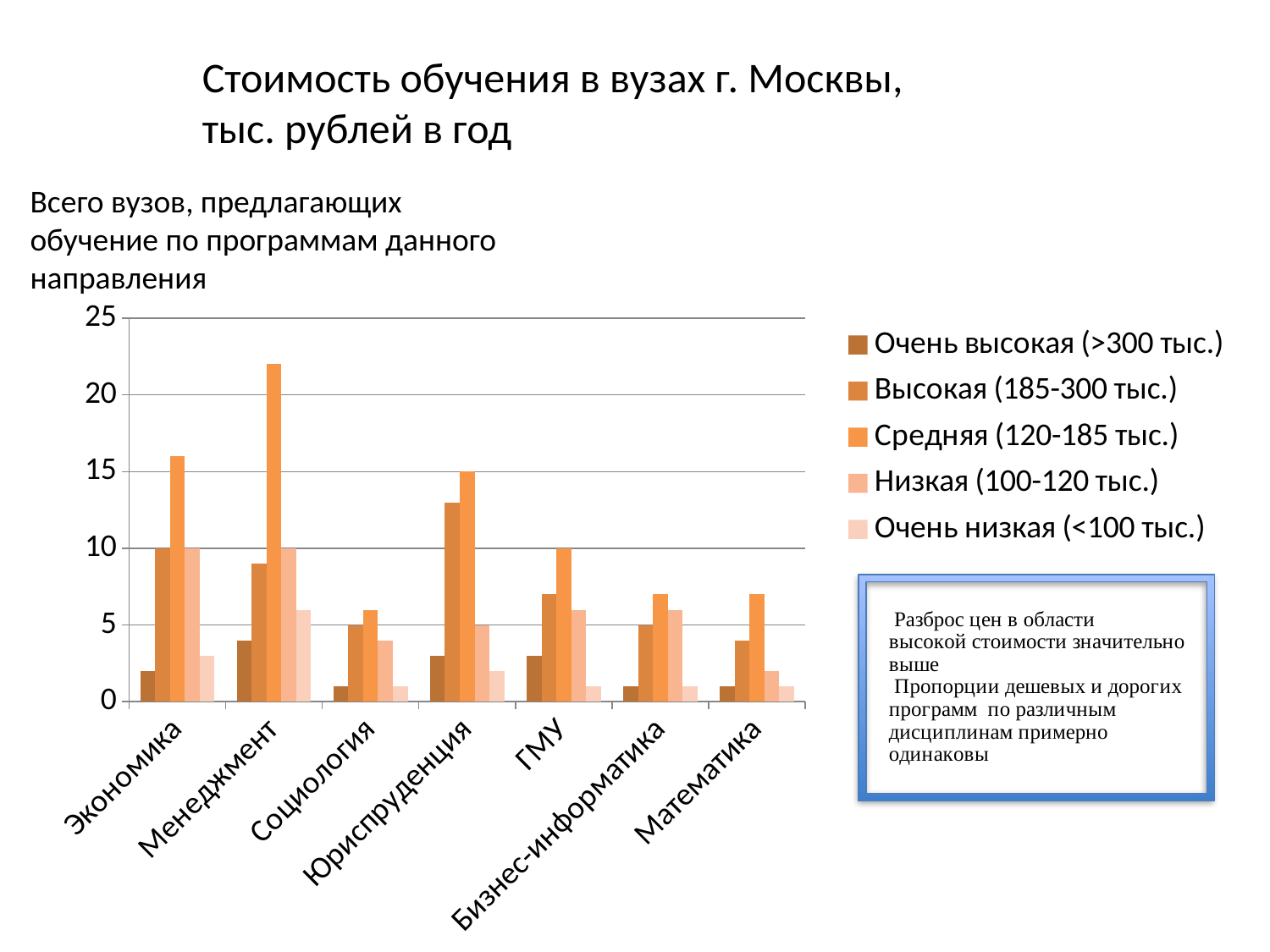
What is the value for "Средняя (120-185 тыс.)" in ГМУ? 10 Is the value for "Средняя (120-185 тыс.)" in Менеджмент greater or less than 20? greater Which category has the lowest value for the series "Средняя (120-185 тыс.)"? Социология What kind of chart is shown on the slide? bar chart How many categories (fields of study) are shown on the x axis? 7 Which category has the tallest bar for the series "Средняя (120-185 тыс.)"? Менеджмент How many series does the legend list? 5 Which legend entry corresponds to the lightest-coloured bars? Очень низкая (<100 тыс.) What is the value for "Средняя (120-185 тыс.)" in Юриспруденция? 15 Is the value for "Очень высокая (>300 тыс.)" in Менеджмент greater or less than 5? less Is the value for "Средняя (120-185 тыс.)" in Экономика greater or less than 15? greater Which is larger: the "Средняя (120-185 тыс.)" value for Социология or for Юриспруденция? Юриспруденция